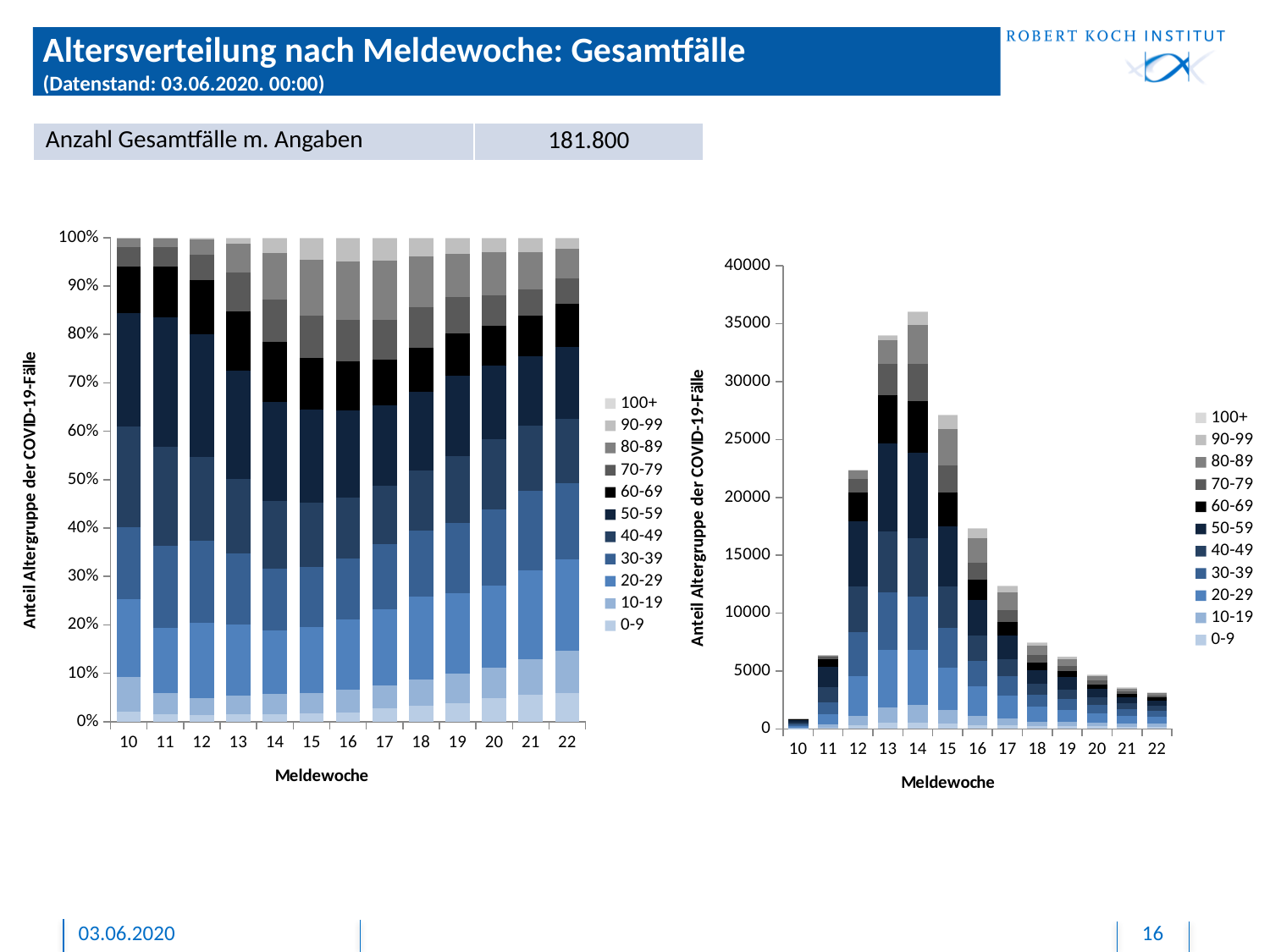
In the right-hand chart, how many reporting weeks (Meldewoche) are shown on the x axis? 13 In the right-hand chart, is the total for reporting week 13 greater or less than 30000? greater How many age-group series does the legend of the left-hand chart list? 11 In the right-hand chart, do the total case numbers rise or fall from reporting week 14 to week 22? Fall In the left-hand chart, is the share of the 0-9 age group in reporting week 22 greater or less than 10%? less In the right-hand chart, which reporting week has the lowest total number of cases? 10 In the right-hand chart, is the total for reporting week 16 greater or less than 20000? less In the right-hand chart, which reporting week has the larger total: week 12 or week 15? Week 15 What is the x-axis title of the left-hand chart? Meldewoche In the right-hand chart, which reporting week has the highest total number of cases? 14 What kind of chart is the right-hand chart on the slide? Stacked bar chart